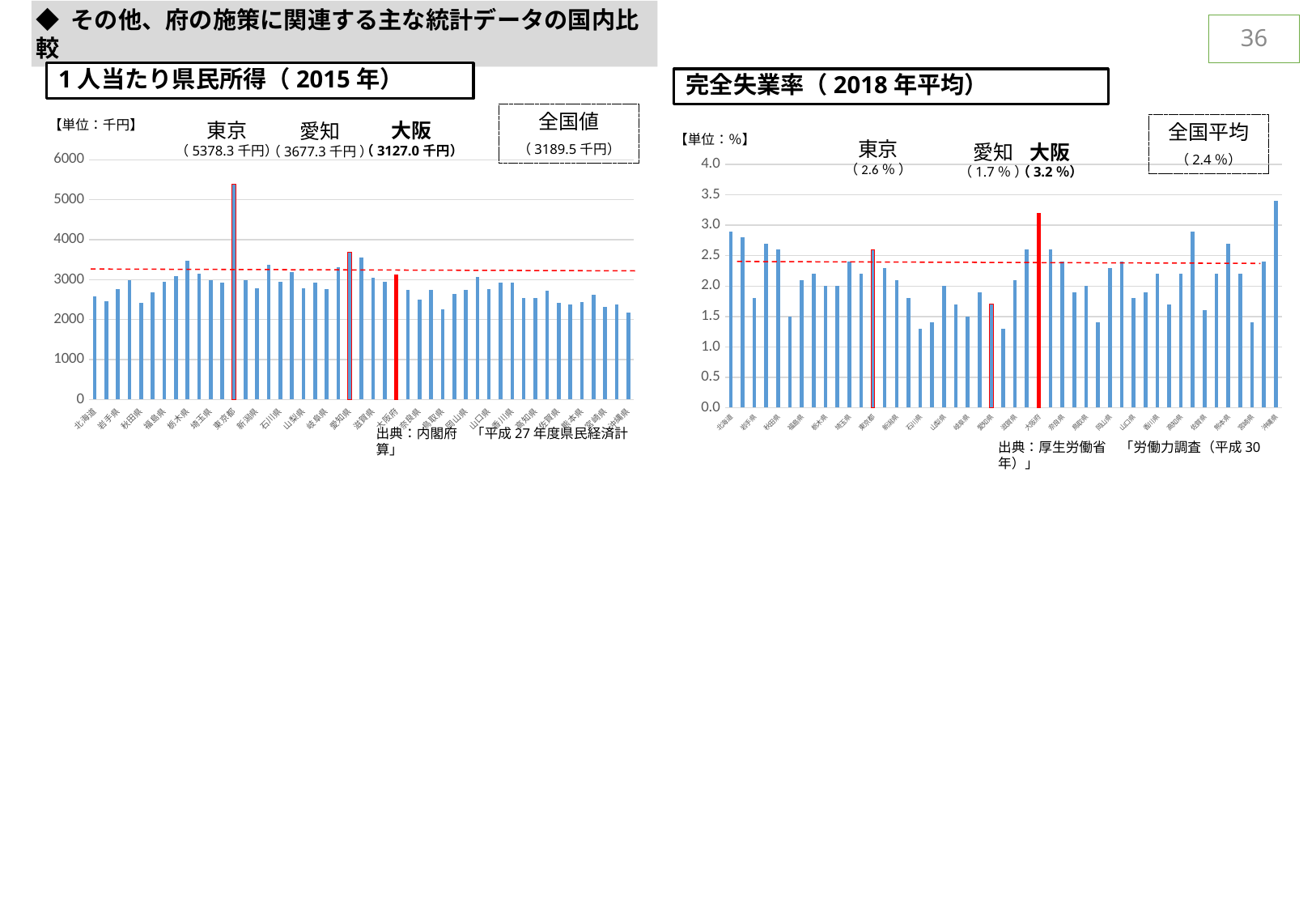
In the 1人当たり県民所得（2015年） chart, what is the difference between the values for 東京 and 大阪? 2251.3 千円 In the 1人当たり県民所得（2015年） chart, what is the value for 東京? 5378.3 千円 In the 1人当たり県民所得（2015年） chart, what is the value for 大阪? 3127.0 千円 In the 完全失業率（2018年平均） chart, what is the 全国平均 (national average)? 2.4 % In the 完全失業率（2018年平均） chart, is the value for 北海道 (the first bar) greater or less than 2.5? greater In the 完全失業率（2018年平均） chart, what is the value for 愛知? 1.7 % In the 1人当たり県民所得（2015年） chart, what is the 全国値 (national value)? 3189.5 千円 In the 完全失業率（2018年平均） chart, what is the difference between the values for 大阪 and 東京? 0.6 % In the 完全失業率（2018年平均） chart, what is the value for 大阪? 3.2 % In the 1人当たり県民所得（2015年） chart, which of 愛知 and 大阪 has the larger value? 愛知 What kind of chart is the 1人当たり県民所得（2015年） chart? Bar chart In the 1人当たり県民所得（2015年） chart, which prefecture has the highest value? 東京都